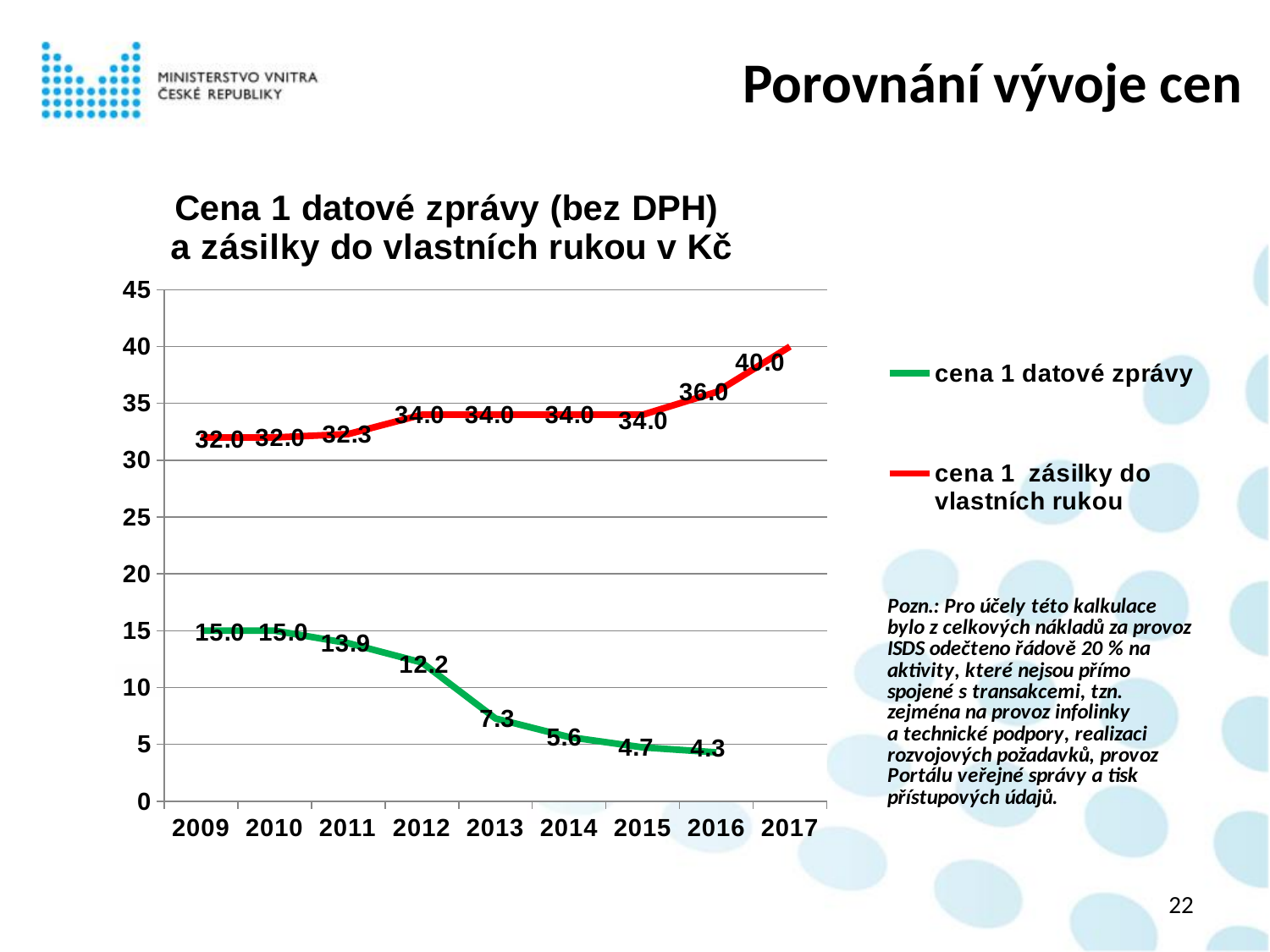
What is the value of 'cena 1 datové zprávy' in 2013? 7.3 Which is larger in 2015: 'cena 1 datové zprávy' or 'cena 1 zásilky do vlastních rukou'? cena 1 zásilky do vlastních rukou What is the difference between 'cena 1 zásilky do vlastních rukou' and 'cena 1 datové zprávy' in 2009? 17.0 In which year is 'cena 1 zásilky do vlastních rukou' highest? 2017 What is the value of 'cena 1 datové zprávy' in 2016? 4.3 How many years are shown on the x axis? 9 What kind of chart is shown on the slide? line chart What is the value of 'cena 1 zásilky do vlastních rukou' in 2011? 32.3 Does 'cena 1 datové zprávy' rise or fall from 2009 to 2016? fall In which year is 'cena 1 datové zprávy' lowest? 2016 By how much did 'cena 1 datové zprávy' fall from 2012 to 2013? 4.9 What is the value of 'cena 1 zásilky do vlastních rukou' in 2017? 40.0